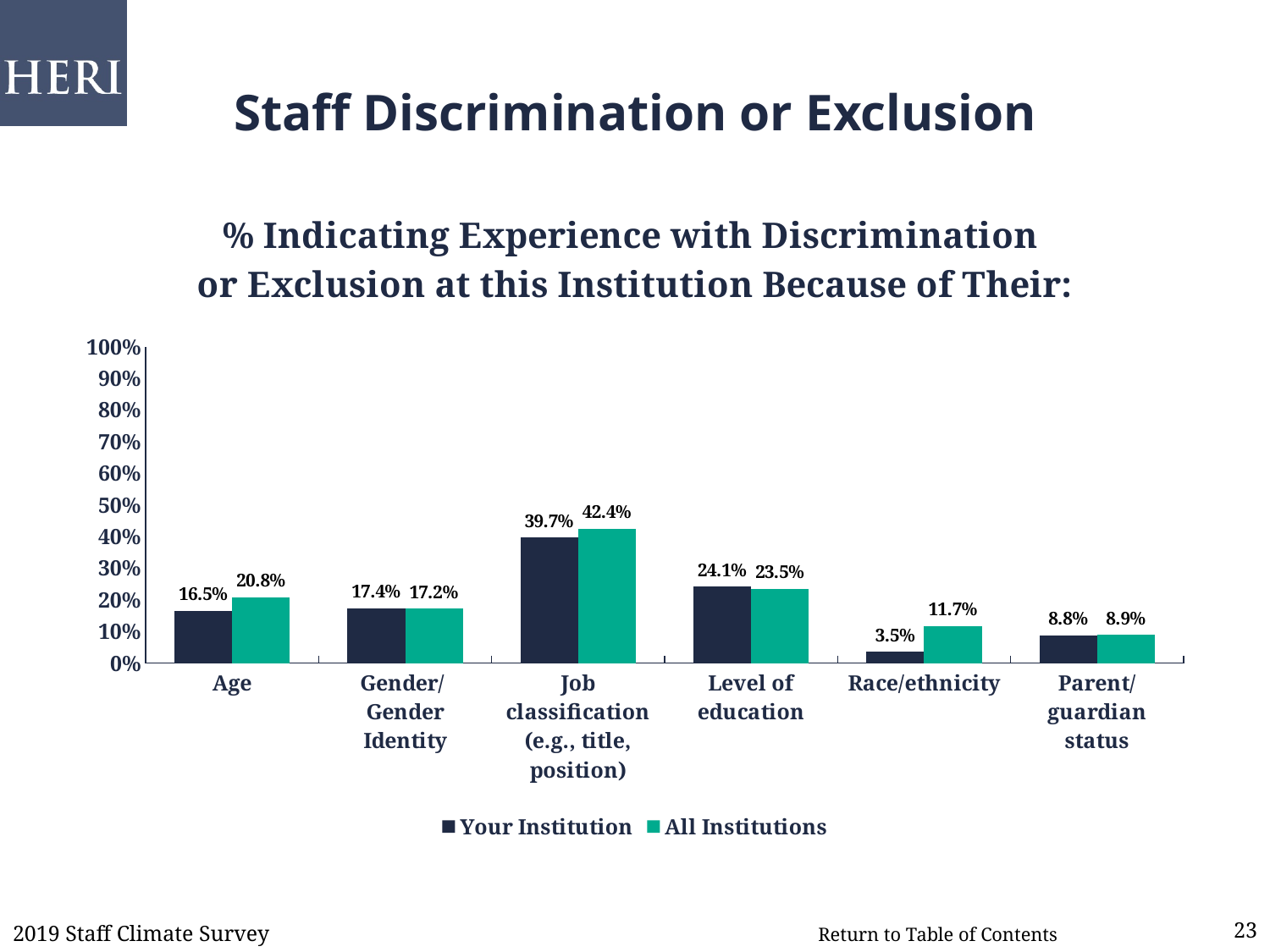
What is the value for Your Institution for Age? 16.5% What is the value for All Institutions for Race/ethnicity? 11.7% What is the difference between All Institutions and Your Institution for Race/ethnicity? 8.2% How many series does the legend list? 2 Which category has the lowest value for Your Institution? Race/ethnicity Which category has the highest value for All Institutions? Job classification (e.g., title, position) Which is larger for Level of education: Your Institution or All Institutions? Your Institution What is the difference between All Institutions and Your Institution for Age? 4.3% How many categories are shown on the x axis? 6 Is the value for All Institutions for Job classification greater or less than 40%? greater What is the value for Your Institution for Job classification (e.g., title, position)? 39.7% What kind of chart is shown on the slide? Bar chart